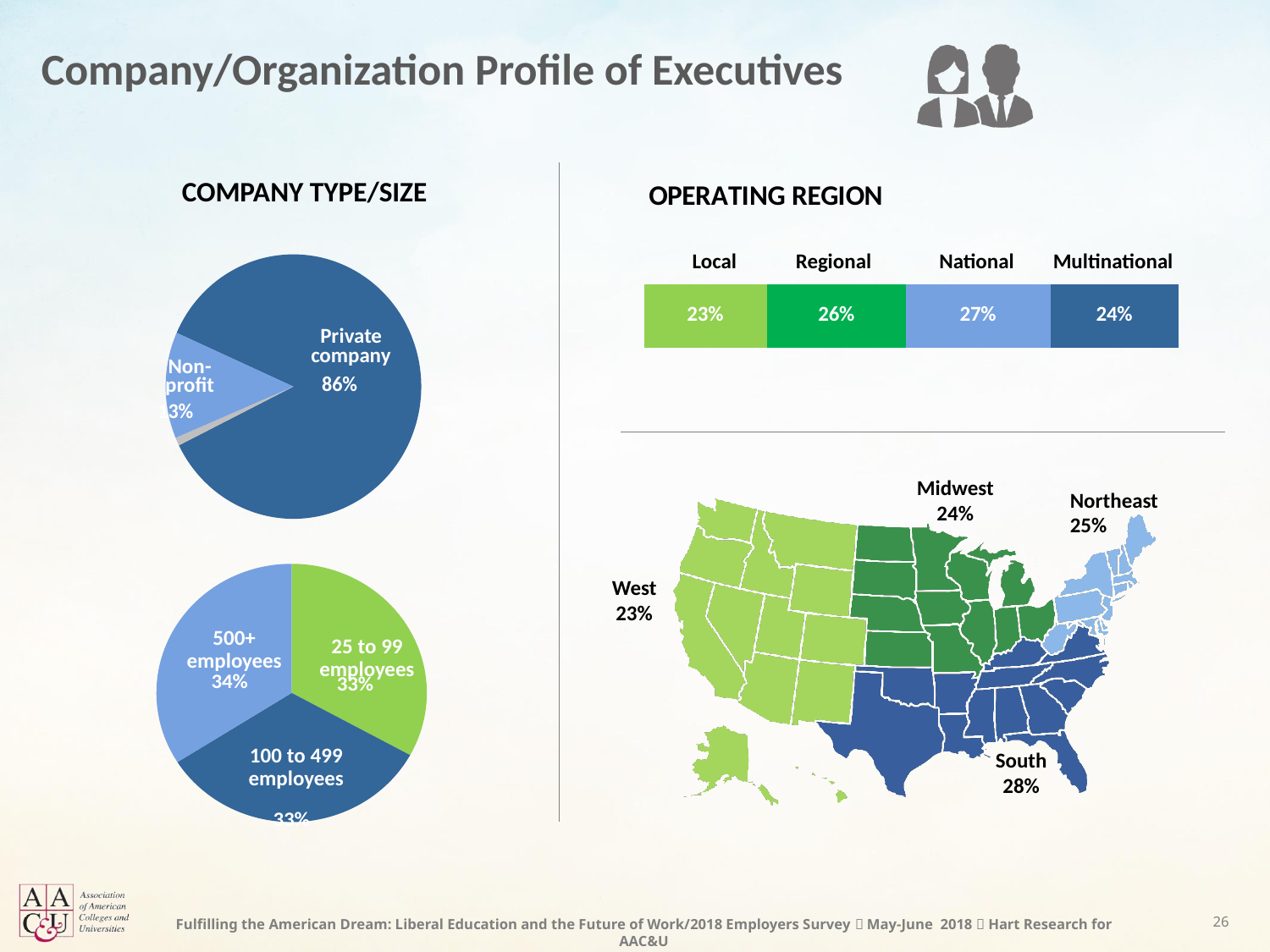
On the map of the United States, which region has the highest percentage of executives? South In the company size pie chart at the bottom left, what percentage of executives are from companies with 500+ employees? 34% In the Operating Region bar, what percentage of executives are from national organizations? 27% In the company size pie chart at the bottom left, what percentage of executives are from companies with 25 to 99 employees? 33% In the Operating Region bar, which category has the lowest percentage? Local In the Operating Region bar, what is the difference between the Regional and Local percentages? 3 percentage points On the map of the United States, what percentage of executives are from the South? 28% In the Company Type/Size pie chart at the top left, what percentage of executives are from a private company? 86% In the Company Type/Size pie chart at the top left, which category has the largest slice? Private company In the Operating Region bar, which category has the highest percentage? National What kind of chart is used for Company Type/Size on the left of the slide? Pie chart How many categories are shown in the Operating Region bar? 4